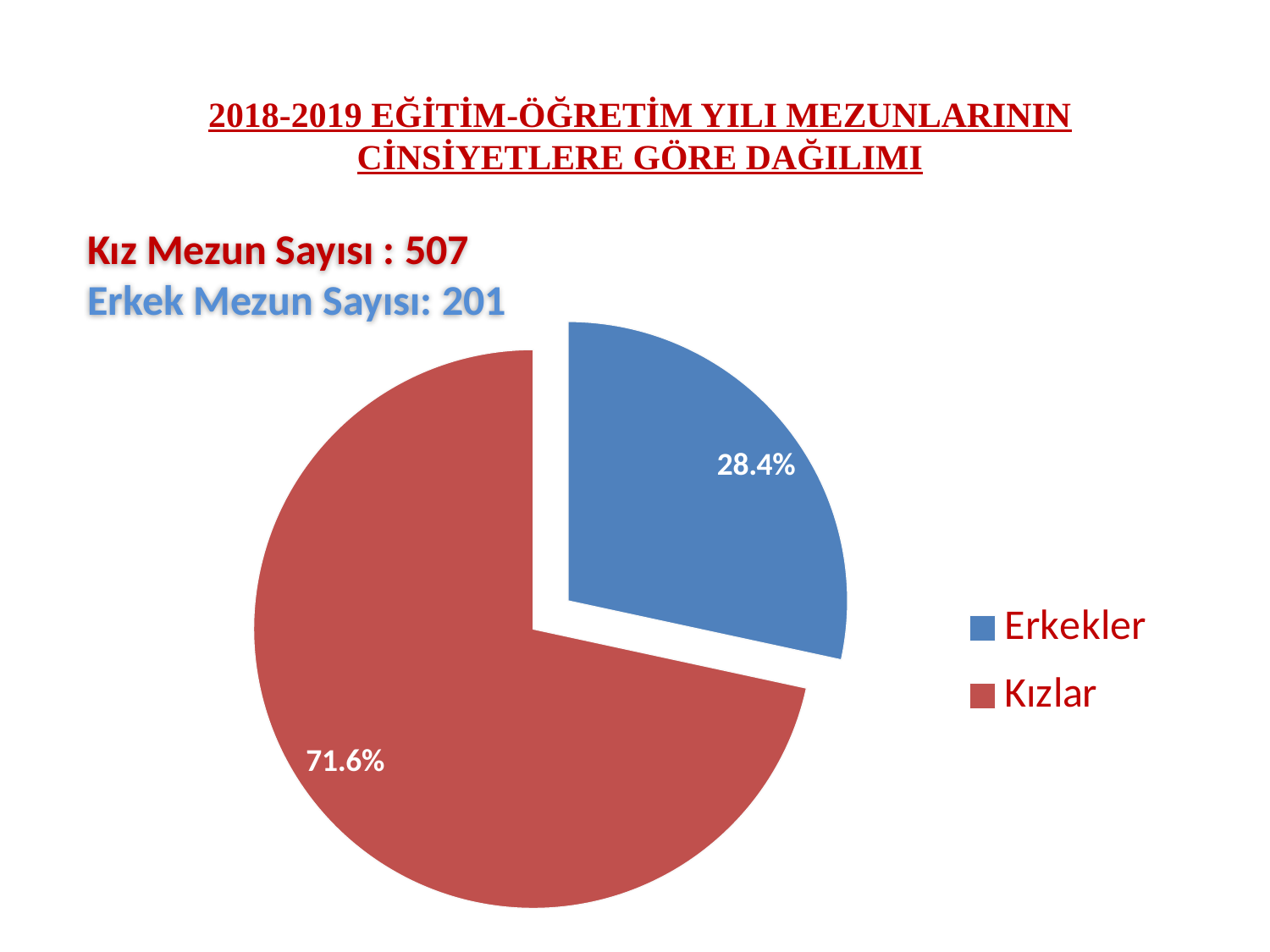
How many slices does the pie chart have? 2 What colour is the Erkekler slice? blue What percentage share does the Erkekler slice have? 28.4% What kind of chart is shown on the slide? pie chart Is the share of the Kızlar slice greater or less than 50%? greater Which slice is the smallest in the pie chart? Erkekler What is the difference in percentage points between the Kızlar and Erkekler slices? 43.2 What colour is the Kızlar slice? red What percentage share does the Kızlar slice have? 71.6% Which is larger, the Erkekler slice or the Kızlar slice? Kızlar How many entries does the legend list? 2 Which slice is the largest in the pie chart? Kızlar